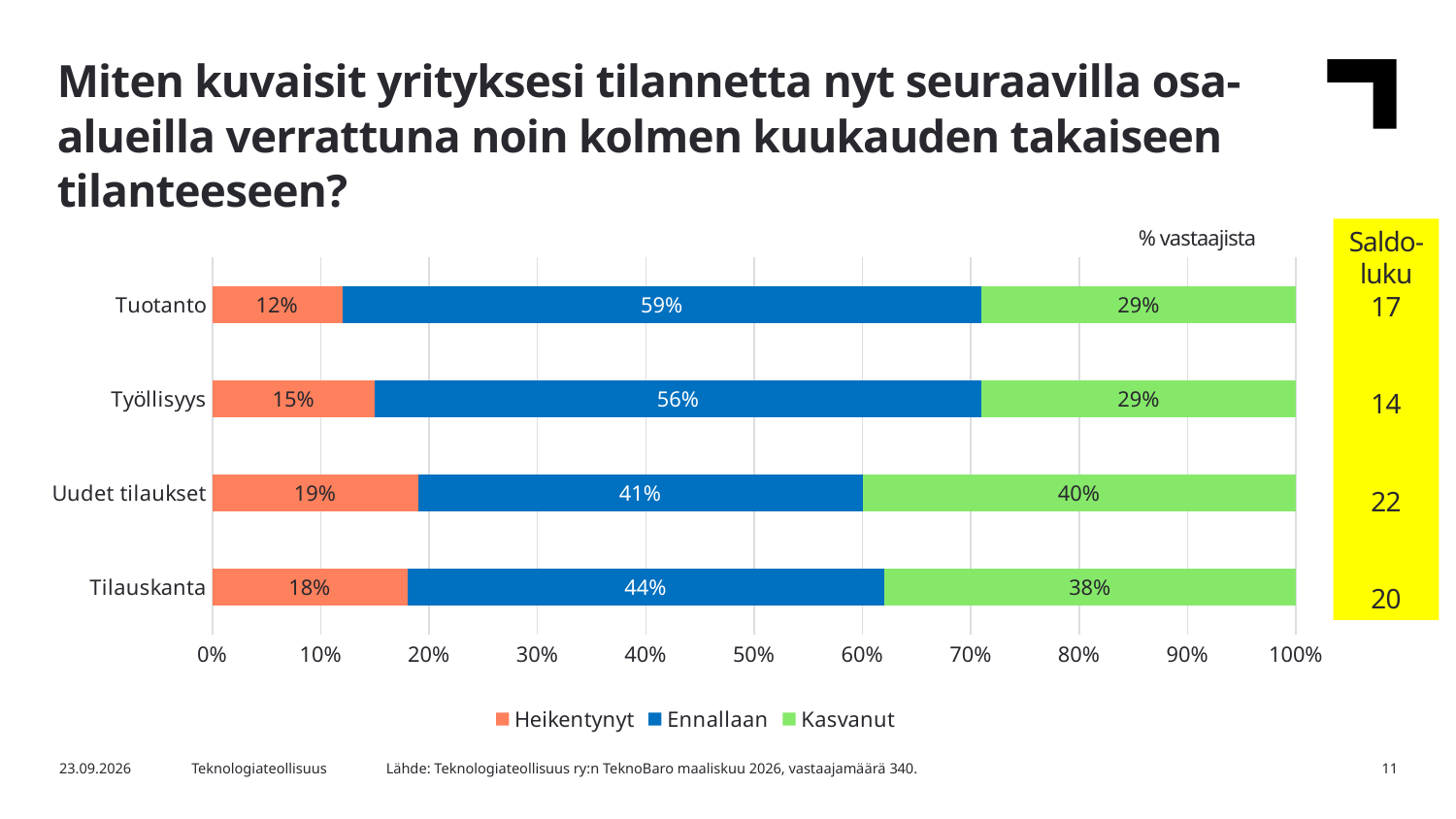
What is the "Kasvanut" value for Uudet tilaukset? 40% How many series does the legend list? 3 What is the difference between the "Kasvanut" values for Uudet tilaukset and Tuotanto? 11% What is the total of the stacked bar for Työllisyys? 100% Which is larger: the "Ennallaan" value for Työllisyys or for Tilauskanta? Työllisyys What is the "Heikentynyt" value for Tilauskanta? 18% Which category has the highest "Heikentynyt" share? Uudet tilaukset How many categories are shown on the y axis of the chart? 4 What is the Saldoluku value shown for Uudet tilaukset? 22 What percentage of respondents answered "Ennallaan" for Tuotanto? 59% Which category has the lowest "Ennallaan" share? Uudet tilaukset What kind of chart is shown on the slide? Stacked bar chart